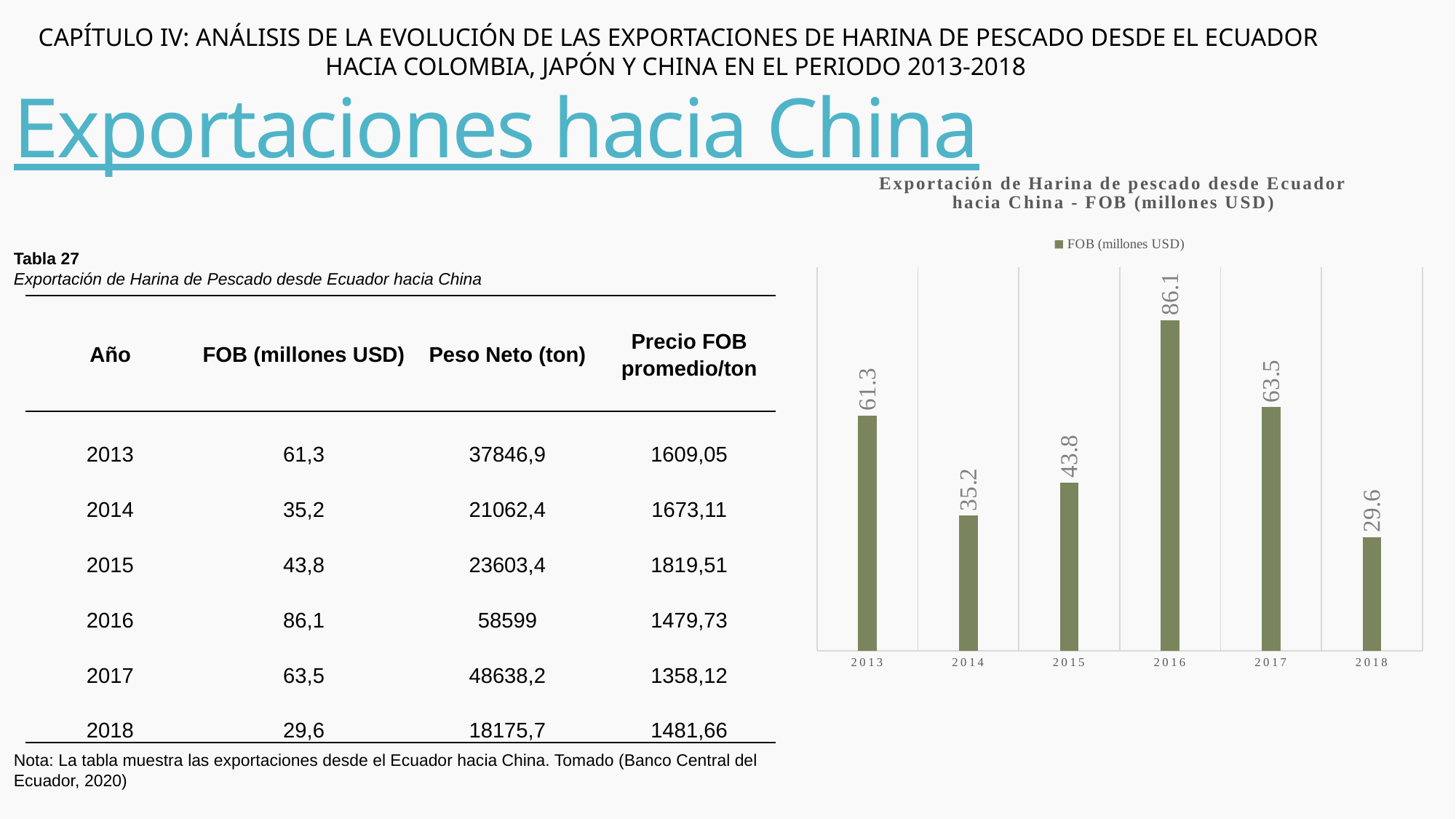
Which year has the lowest FOB value in the chart? 2018 Which year has a larger FOB value in the chart, 2013 or 2017? 2017 How many series does the chart legend list? 1 Which year has the highest FOB value in the chart? 2016 Does the FOB value rise or fall from 2017 to 2018 in the chart? fall What is the FOB value (millions USD) for 2018 in the chart? 29.6 What is the legend entry of the chart? FOB (millones USD) What type of chart is shown on the slide? bar chart What is the difference between the FOB values for 2016 and 2017 in the chart? 22.6 How many years are shown on the x axis of the chart? 6 What is the FOB value (millions USD) for 2014 in the chart? 35.2 What is the FOB value (millions USD) for 2016 in the chart? 86.1